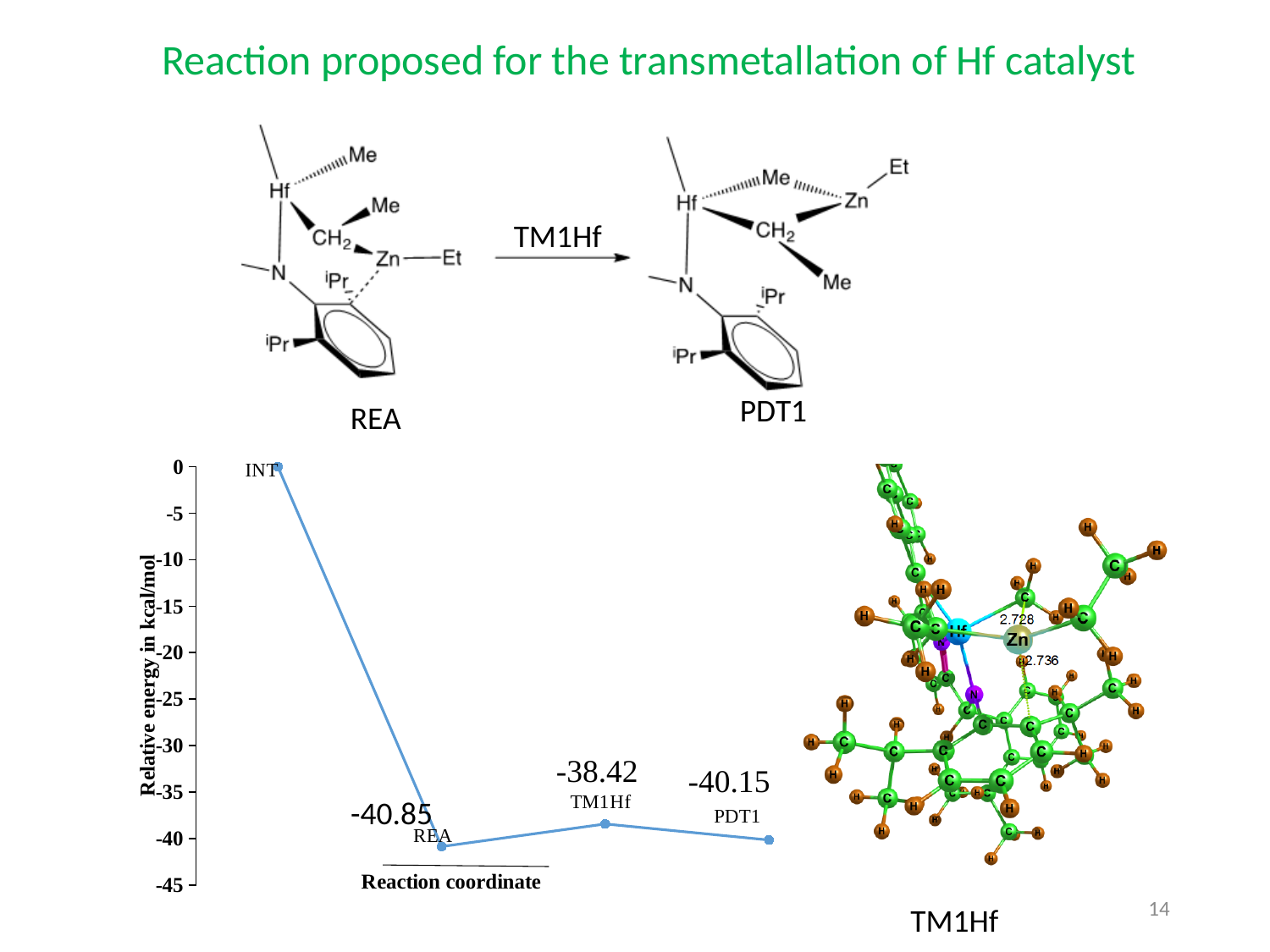
What kind of chart shows the relative energy along the reaction coordinate? Line chart How many points are plotted on the line chart? 4 Does the relative energy rise or fall from INT to REA? Fall Which has the higher relative energy, REA or PDT1? PDT1 What is the relative energy of REA in the line chart? -40.85 What is the label of the y axis of the line chart? Relative energy in kcal/mol What is the relative energy of PDT1 in the line chart? -40.15 Which point on the line chart has the lowest relative energy? REA What is the difference in relative energy between TM1Hf and REA? 2.43 What is the relative energy of TM1Hf in the line chart? -38.42 What is the difference in relative energy between TM1Hf and PDT1? 1.73 Which point on the line chart has the highest relative energy? INT